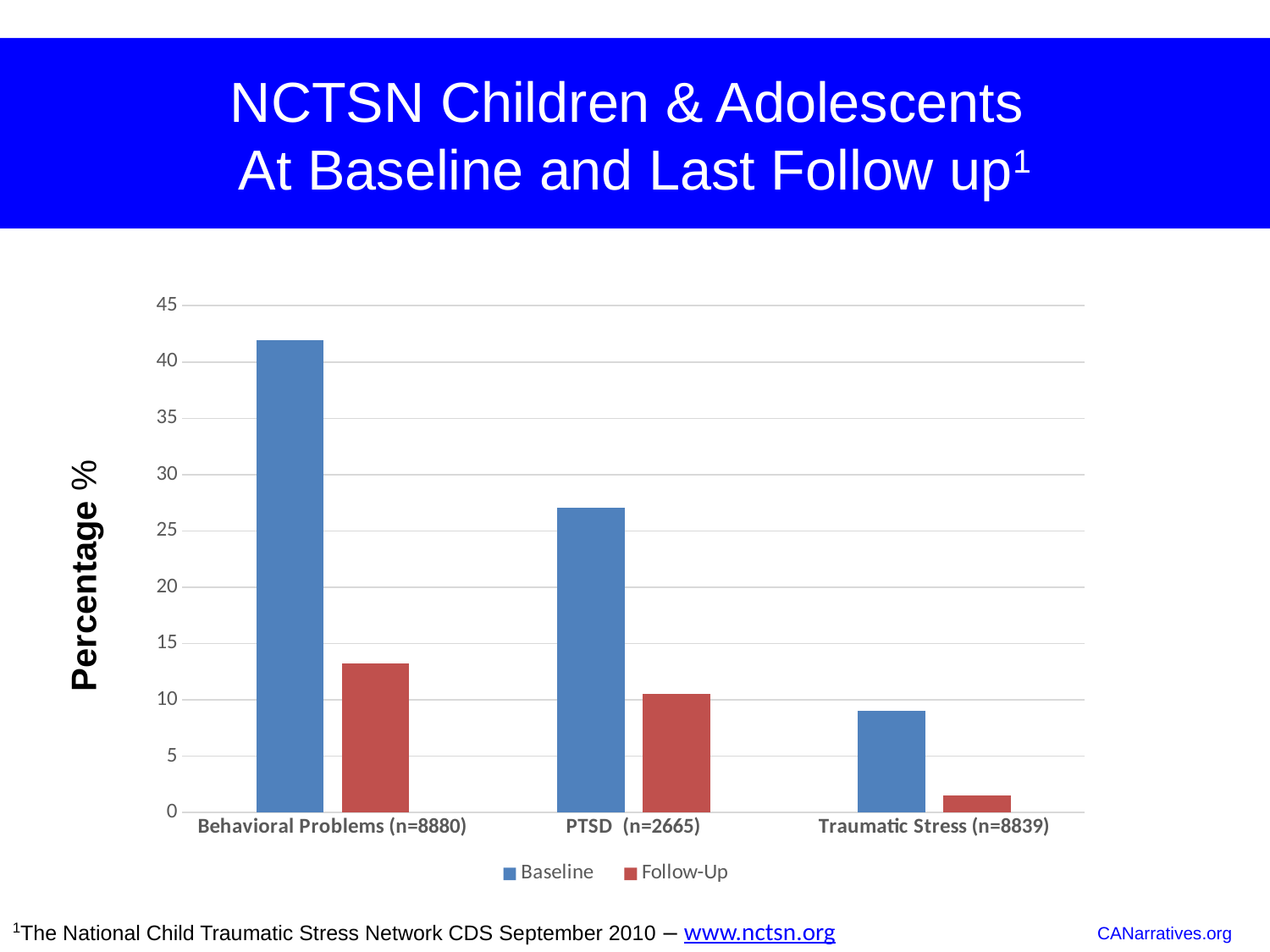
How many series does the chart's legend list? 2 Is the Follow-Up value for Traumatic Stress (n=8839) greater or less than 5? less Which category has the highest Baseline value? Behavioral Problems (n=8880) Is the Baseline value for Traumatic Stress (n=8839) greater or less than 10? less What kind of chart is shown on the slide? bar chart Is the Follow-Up value for Behavioral Problems (n=8880) greater or less than 10? greater For PTSD (n=2665), which is larger, the Baseline value or the Follow-Up value? Baseline What is the label on the vertical axis of the chart? Percentage % Which category has the lowest Follow-Up value? Traumatic Stress (n=8839) How many categories are shown on the x axis of the chart? 3